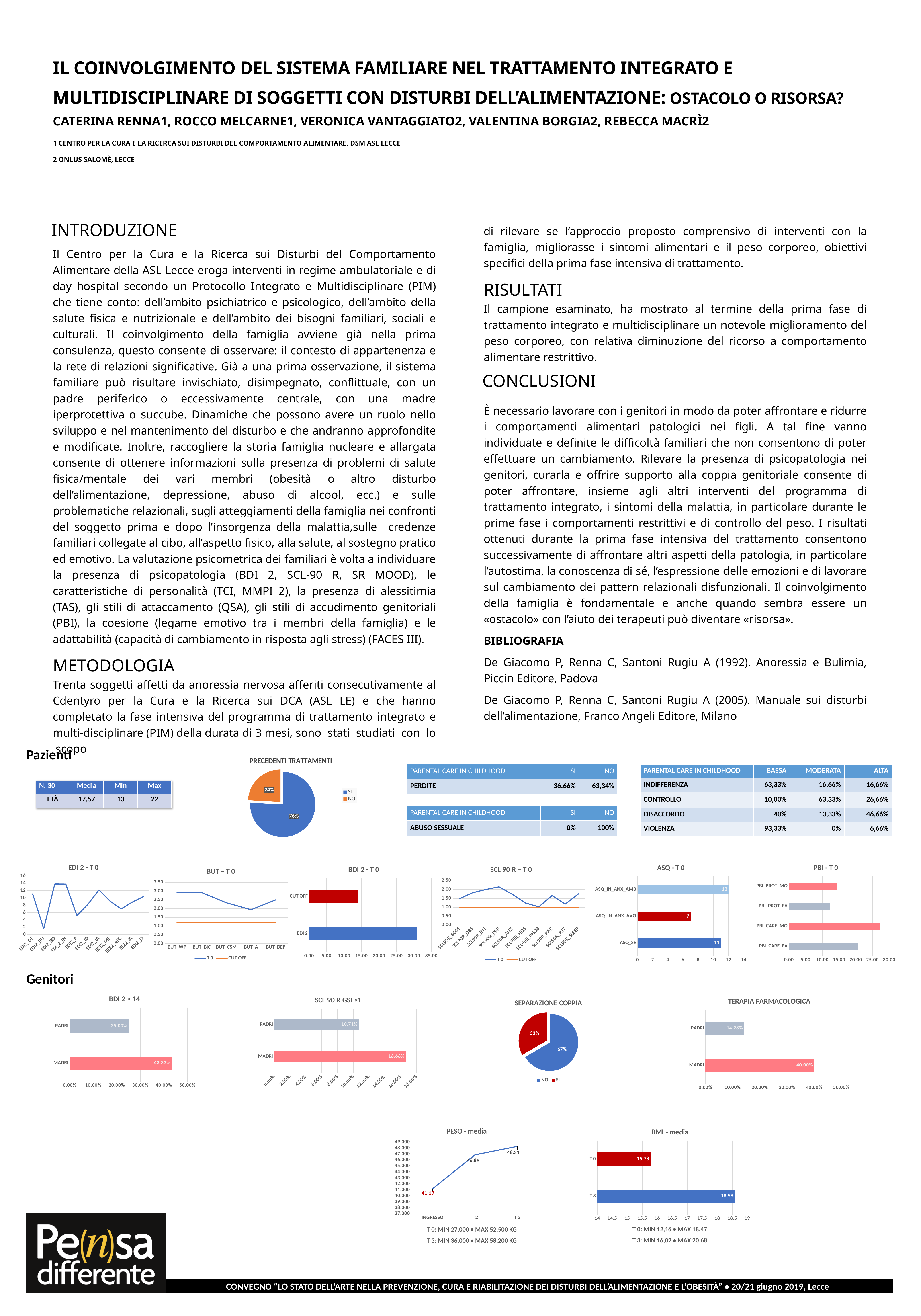
In the "SCL 90 R GSI >1" chart, what is the value for PADRI? 10.71% In the "SEPARAZIONE COPPIA" pie chart, what share is labelled SI? 33% In the "BDI 2 > 14" chart, what is the value for MADRI? 43.33% In the "ASQ - T 0" chart, which category has the highest value? ASQ_IN_ANX_AMB In the "TERAPIA FARMACOLOGICA" chart, which is larger, the value for PADRI or for MADRI? MADRI In the "PRECEDENTI TRATTAMENTI" pie chart, what share is labelled SI? 76% In the "BMI - media" chart, what is the value for T 3? 18.58 In the "PESO - media" chart, what is the value at INGRESSO? 41.19 In the "BDI 2 - T 0" chart, is the value for BDI 2 greater or less than 25.00? greater In the "PESO - media" chart, do the values rise or fall from INGRESSO to T 3? rise In the "BDI 2 > 14" chart, what is the difference between the MADRI and PADRI values? 18.33% In the "ASQ - T 0" chart, what is the value for ASQ_IN_ANX_AVO? 7